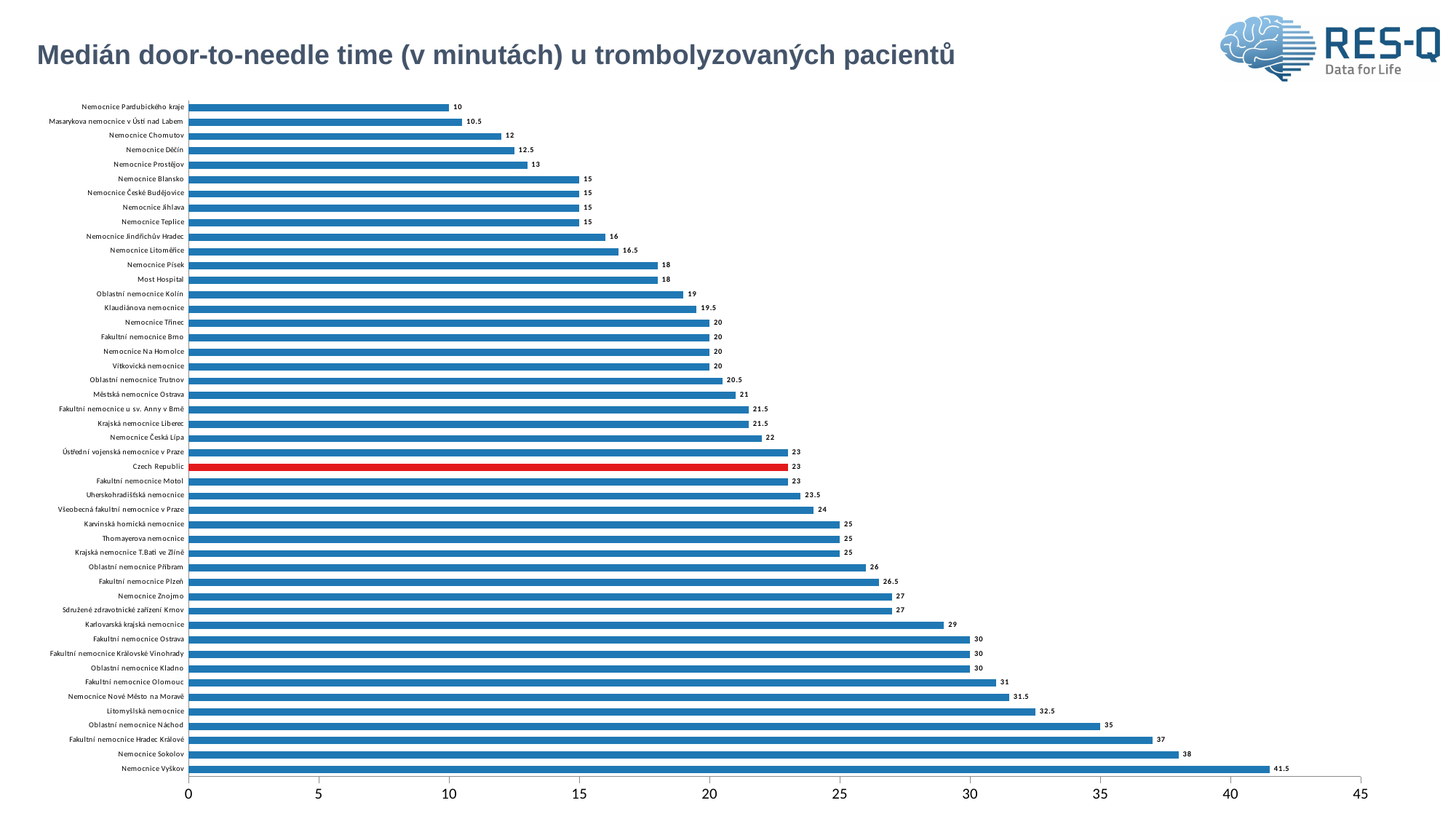
Which hospital has the highest median door-to-needle time? Nemocnice Vyškov Which hospital has the lowest median door-to-needle time? Nemocnice Pardubického kraje What is the value for Nemocnice Sokolov? 38 What type of chart is shown on the slide? bar chart What is the value shown for Czech Republic? 23 How many bars are plotted in the chart? 47 Is the value for Karlovarská krajská nemocnice greater or less than 30? less What is the median door-to-needle time for Fakultní nemocnice Motol? 23 Which bar is highlighted in red? Czech Republic Which has a larger value, Fakultní nemocnice Hradec Králové or Oblastní nemocnice Náchod? Fakultní nemocnice Hradec Králové What is the difference between the values for Nemocnice Vyškov and Nemocnice Pardubického kraje? 31.5 What is the median door-to-needle time for Nemocnice Vyškov? 41.5